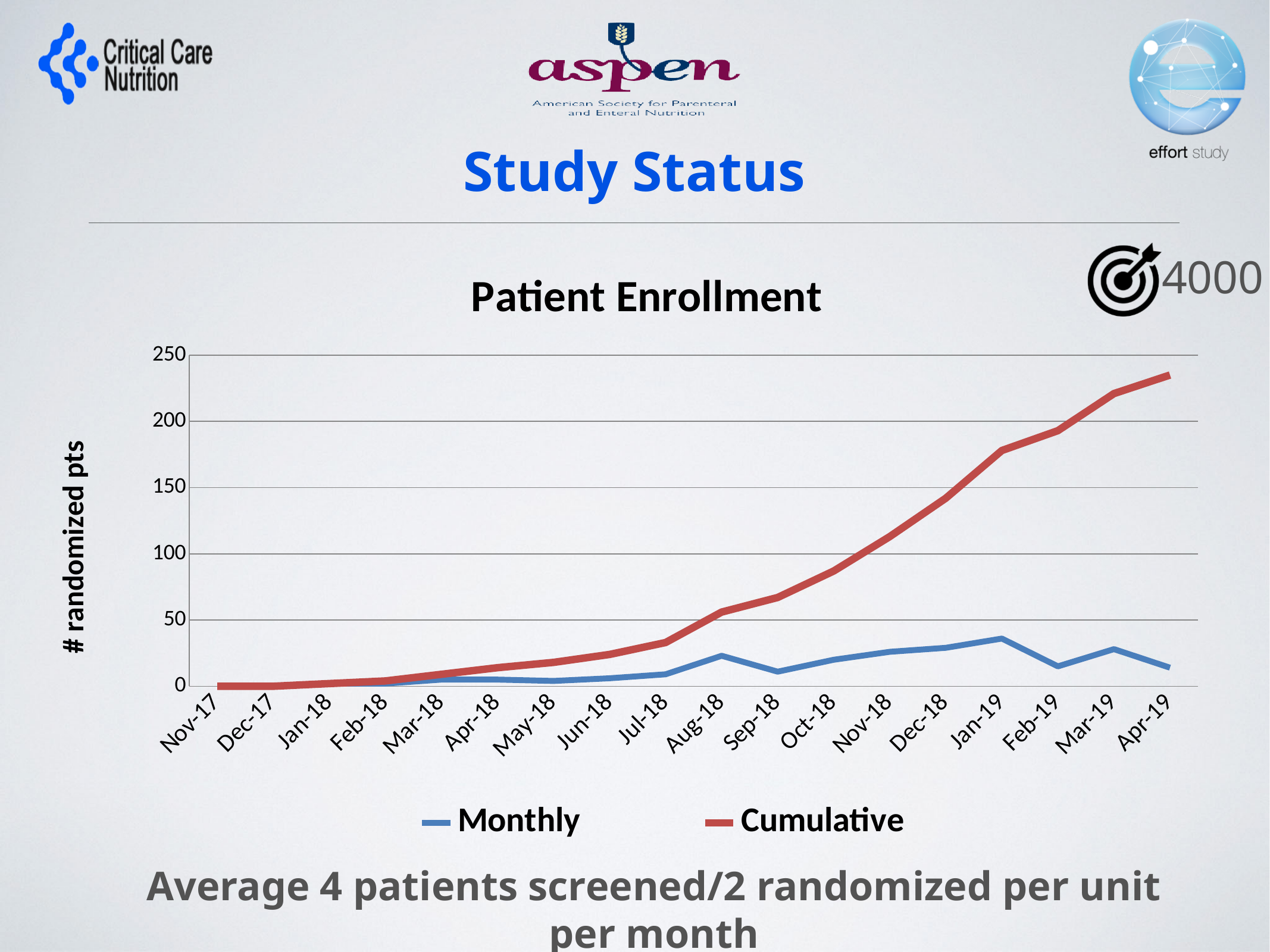
What is the label on the y axis? # randomized pts Which series has the larger value in Apr-19, Monthly or Cumulative? Cumulative Is the Cumulative value for Apr-19 greater or less than 200? greater Is the Monthly value for Jan-19 greater or less than 50? less In which month is the Cumulative series highest? Apr-19 What kind of chart is shown on the slide? line chart Is the Cumulative value for Jan-19 greater or less than 150? greater What is the title of the chart? Patient Enrollment In which month is the Monthly series highest? Jan-19 How many months are shown along the x axis? 18 How many series does the legend list? 2 Does the Cumulative series rise or fall from Nov-17 to Apr-19? rise